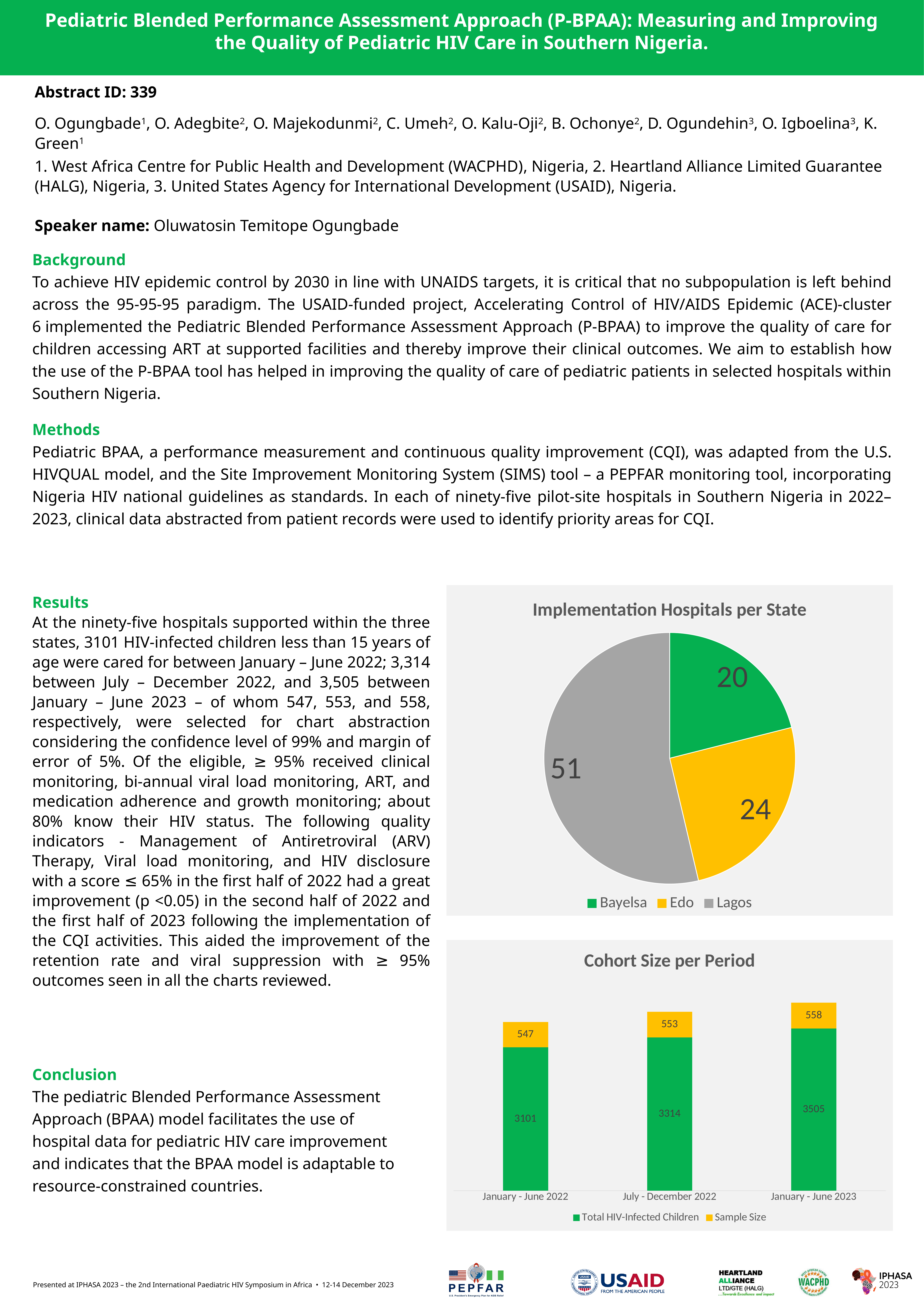
In the 'Implementation Hospitals per State' chart, what is the difference between the number of hospitals in Lagos and Edo? 27 In the 'Cohort Size per Period' chart, what is the difference in Sample Size between January - June 2023 and January - June 2022? 11 How many series does the legend of the 'Cohort Size per Period' chart list? 2 In the 'Cohort Size per Period' chart, what is the Total HIV-Infected Children value for July - December 2022? 3314 In the 'Cohort Size per Period' chart, how does the Total HIV-Infected Children value change across the three periods? It rises In the 'Cohort Size per Period' chart, what is the Sample Size for January - June 2023? 558 In the 'Implementation Hospitals per State' chart, how many hospitals are in Lagos? 51 What type of chart is 'Implementation Hospitals per State'? Pie chart In the 'Cohort Size per Period' chart, what is the total height of the stacked bar for January - June 2022? 3648 In the 'Implementation Hospitals per State' chart, which state has the fewest implementation hospitals? Bayelsa In the 'Implementation Hospitals per State' chart, which colour represents Edo? Yellow